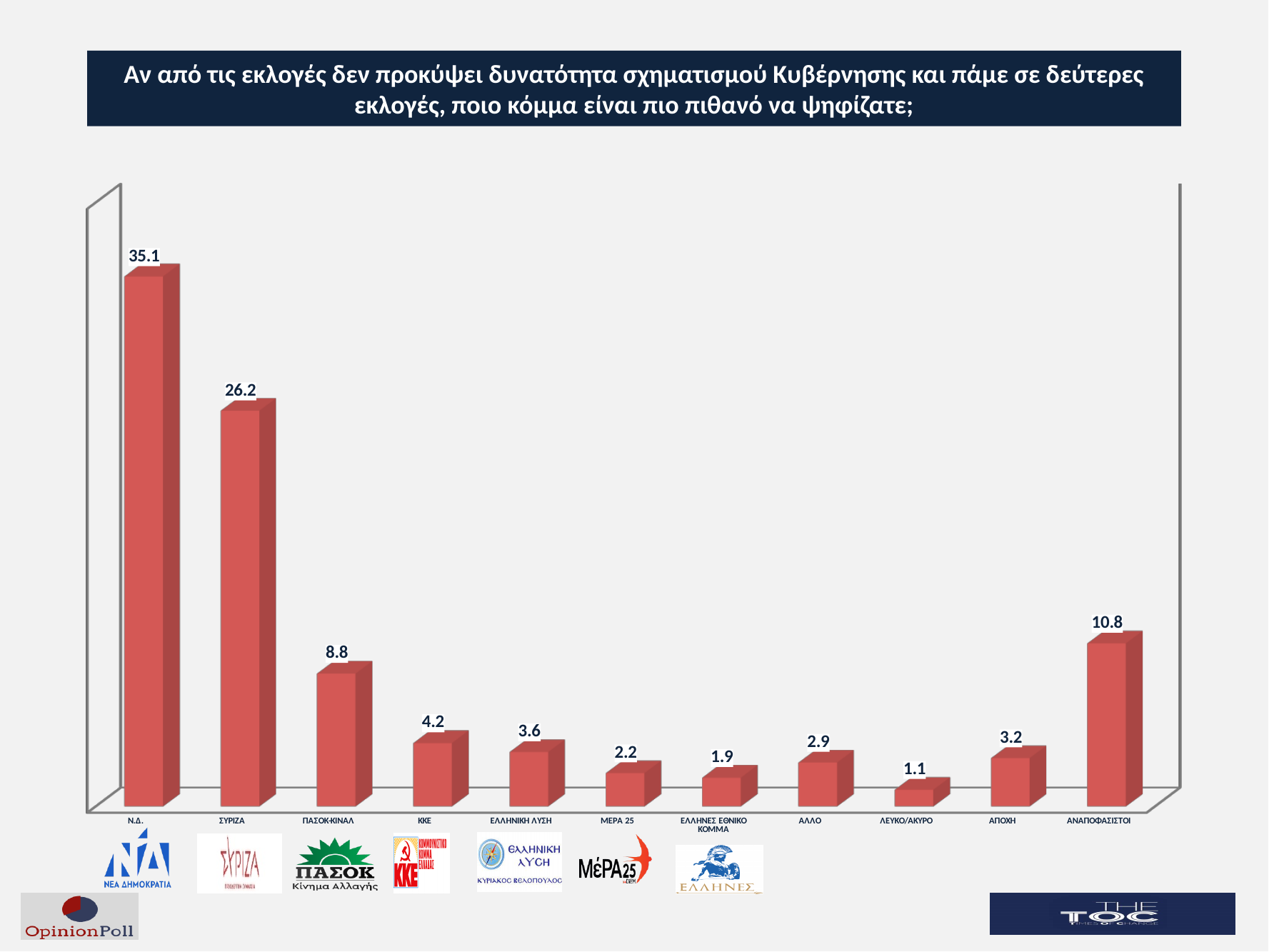
Which is larger, the value for ΑΝΑΠΟΦΑΣΙΣΤΟΙ or the value for ΠΑΣΟΚ-ΚΙΝΑΛ? ΑΝΑΠΟΦΑΣΙΣΤΟΙ What value is shown for ΚΚΕ? 4.2 Which category has the lowest value? ΛΕΥΚΟ/ΑΚΥΡΟ Which category has the highest value? Ν.Δ. What value is shown for ΣΥΡΙΖΑ? 26.2 What kind of chart is shown on the slide? Bar chart How many categories are shown on the chart? 11 What value is shown for ΑΝΑΠΟΦΑΣΙΣΤΟΙ? 10.8 What is the difference between the values for ΠΑΣΟΚ-ΚΙΝΑΛ and ΚΚΕ? 4.6 What value is shown for Ν.Δ.? 35.1 Which is larger, the value for ΑΠΟΧΗ or the value for ΑΛΛΟ? ΑΠΟΧΗ What is the difference between the values for Ν.Δ. and ΣΥΡΙΖΑ? 8.9